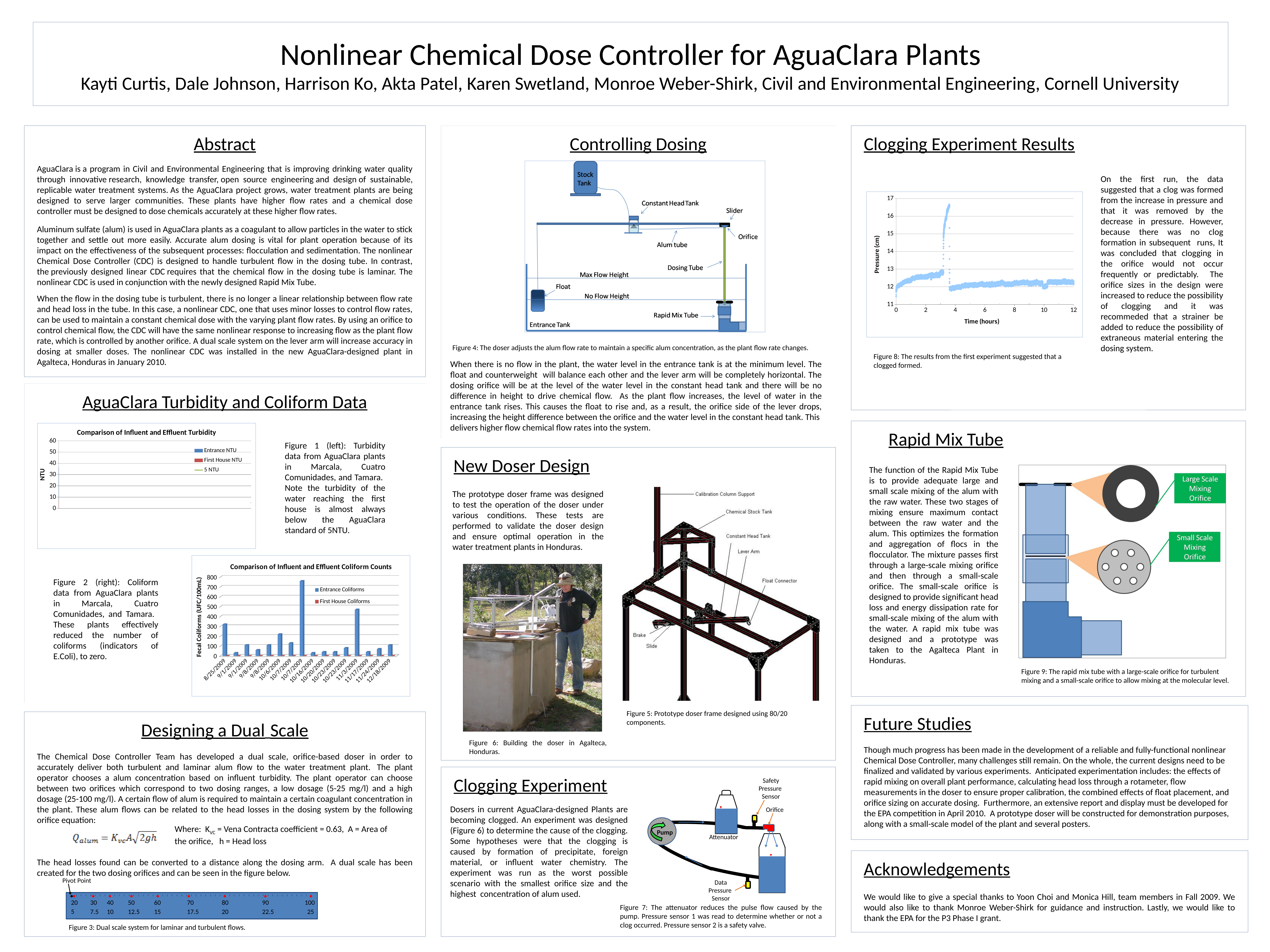
In the 'Comparison of Influent and Effluent Coliform Counts' chart, which date has the highest Entrance Coliforms value? 10/7/2009 In the 'Comparison of Influent and Effluent Coliform Counts' chart, which has the larger Entrance Coliforms value, 10/7/2009 or 11/3/2009? 10/7/2009 In the 'Comparison of Influent and Effluent Turbidity' chart, how many entries does the legend list? 3 In the 'Comparison of Influent and Effluent Coliform Counts' chart, how many series does the legend list? 2 In the 'Comparison of Influent and Effluent Coliform Counts' chart, is the Entrance Coliforms value for 11/3/2009 greater or less than 400? greater In the Clogging Experiment Results chart, what is the x-axis label? Time (hours) In the 'Comparison of Influent and Effluent Coliform Counts' chart, is the Entrance Coliforms value for 8/25/2009 greater or less than 200? greater In the Clogging Experiment Results chart (Pressure vs Time), is the peak pressure value greater or less than 16? greater In the 'Comparison of Influent and Effluent Turbidity' chart, what is the highest value shown on the y-axis? 60 In the 'Comparison of Influent and Effluent Coliform Counts' chart, what is the y-axis label? Fecal Coliforms (UFC/100mL) In the 'Comparison of Influent and Effluent Coliform Counts' chart, what kind of chart is shown? bar chart